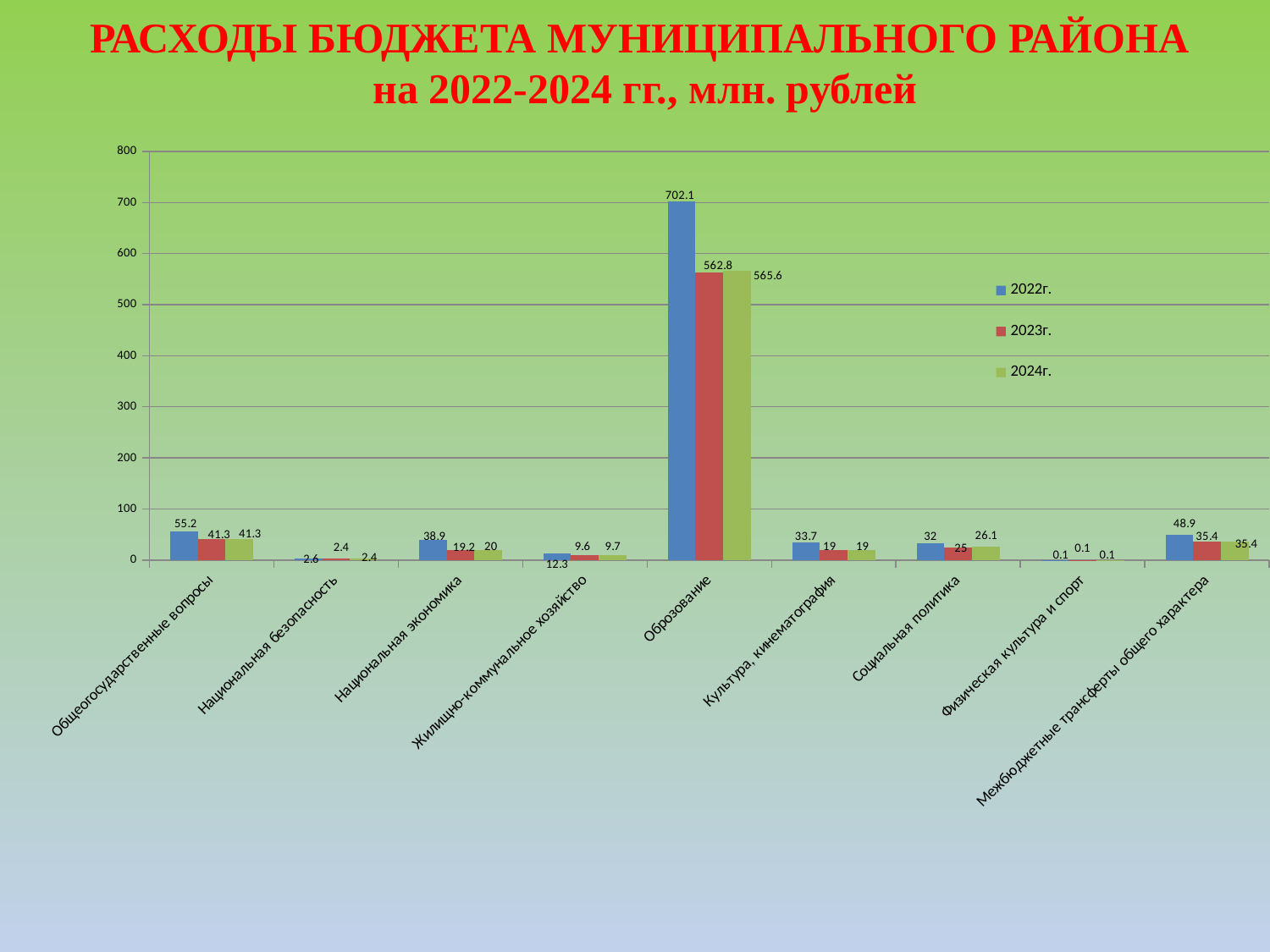
Which is larger for Национальная экономика: the 2022г. value or the 2024г. value? 2022г. Which category has the lowest value in the 2024г. series? Физическая культура и спорт What is the value for Образование in the 2022г. series? 702.1 What kind of chart is shown on the slide? bar chart How many categories are shown on the x axis? 9 Is the 2023г. value for Образование greater or less than 500? greater What is the value for Социальная политика in the 2024г. series? 26.1 Which category has the highest value in the 2022г. series? Оброзование What is the value for Межбюджетные трансферты общего характера in the 2023г. series? 35.4 What is the difference between the 2022г. and 2023г. values for Образование? 139.3 How many series does the legend list? 3 What is the value for Жилищно-коммунальное хозяйство in the 2024г. series? 9.7